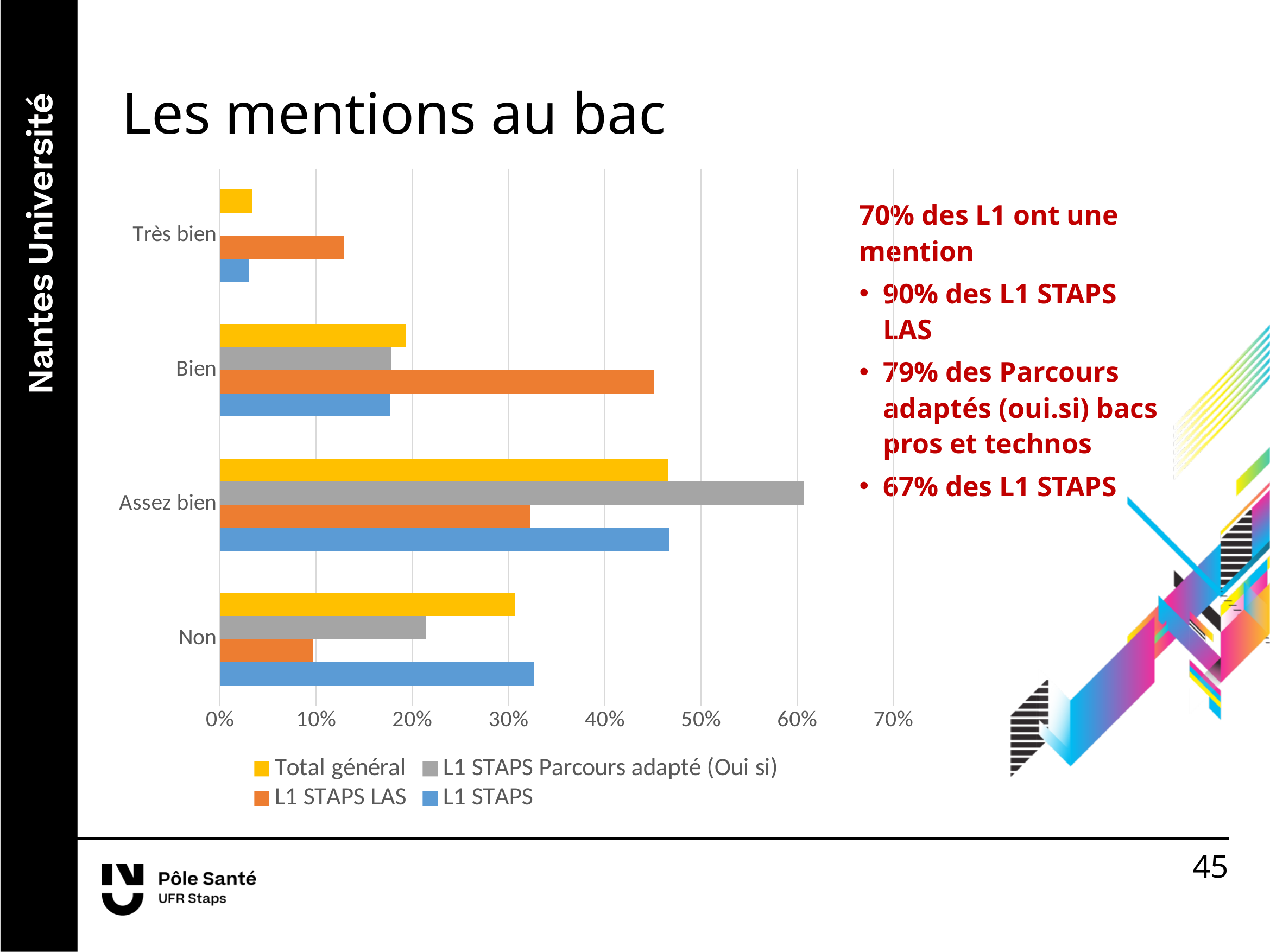
For the category 'Bien', which is larger: the value for L1 STAPS LAS or the value for Total général? L1 STAPS LAS What colour represents the series 'L1 STAPS' in the chart legend? blue For the category 'Non', which is larger: the value for L1 STAPS or the value for L1 STAPS LAS? L1 STAPS What kind of chart is shown on the slide? bar chart Is the value of L1 STAPS LAS for 'Bien' greater or less than 40%? greater Is the value of L1 STAPS for 'Très bien' greater or less than 10%? less How many series does the chart legend list? 4 Which series has the highest value for the category 'Bien'? L1 STAPS LAS Is the value of Total général for 'Assez bien' greater or less than 40%? greater How many categories are shown on the vertical axis of the chart? 4 Which series has the lowest value for the category 'Non'? L1 STAPS LAS Which series has the highest value for the category 'Assez bien'? L1 STAPS Parcours adapté (Oui si)